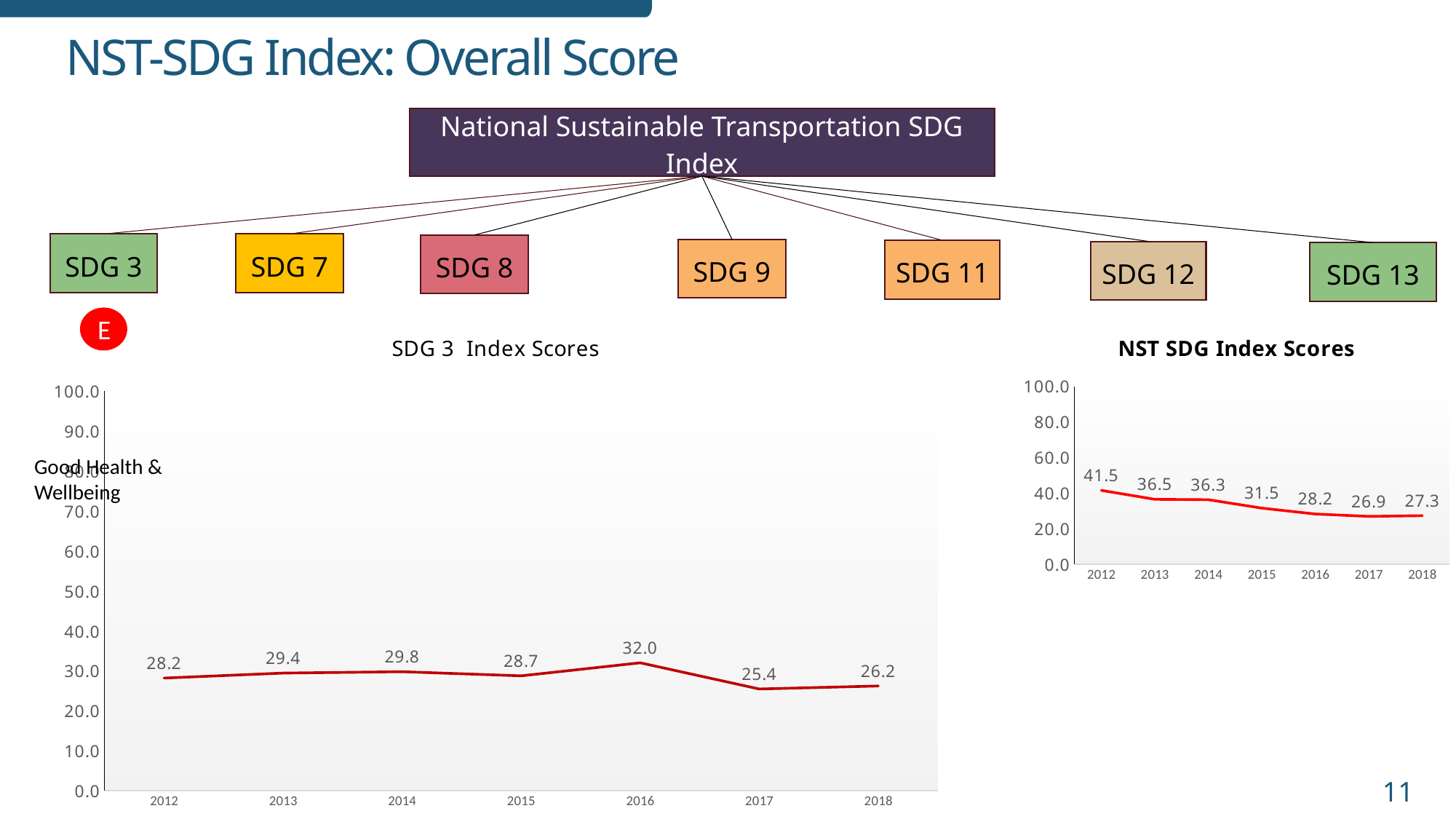
In the NST SDG Index Scores chart, do the values generally rise or fall from 2012 to 2018? fall In the NST SDG Index Scores chart, is the value for 2015 greater or less than 40.0? less In the NST SDG Index Scores chart, which year has the lowest value? 2017 In the NST SDG Index Scores chart, what is the value for 2012? 41.5 In the SDG 3 Index Scores chart, what is the value for 2016? 32.0 In the NST SDG Index Scores chart, what is the difference between the 2012 and 2018 values? 14.2 In the SDG 3 Index Scores chart, how many years are plotted? 7 In the SDG 3 Index Scores chart, what is the difference between the 2016 and 2017 values? 6.6 In the SDG 3 Index Scores chart, which year has the lowest value? 2017 In the SDG 3 Index Scores chart, which year has the highest value? 2016 What kind of chart is the SDG 3 Index Scores chart? line chart In the NST SDG Index Scores chart, which year has the highest value? 2012